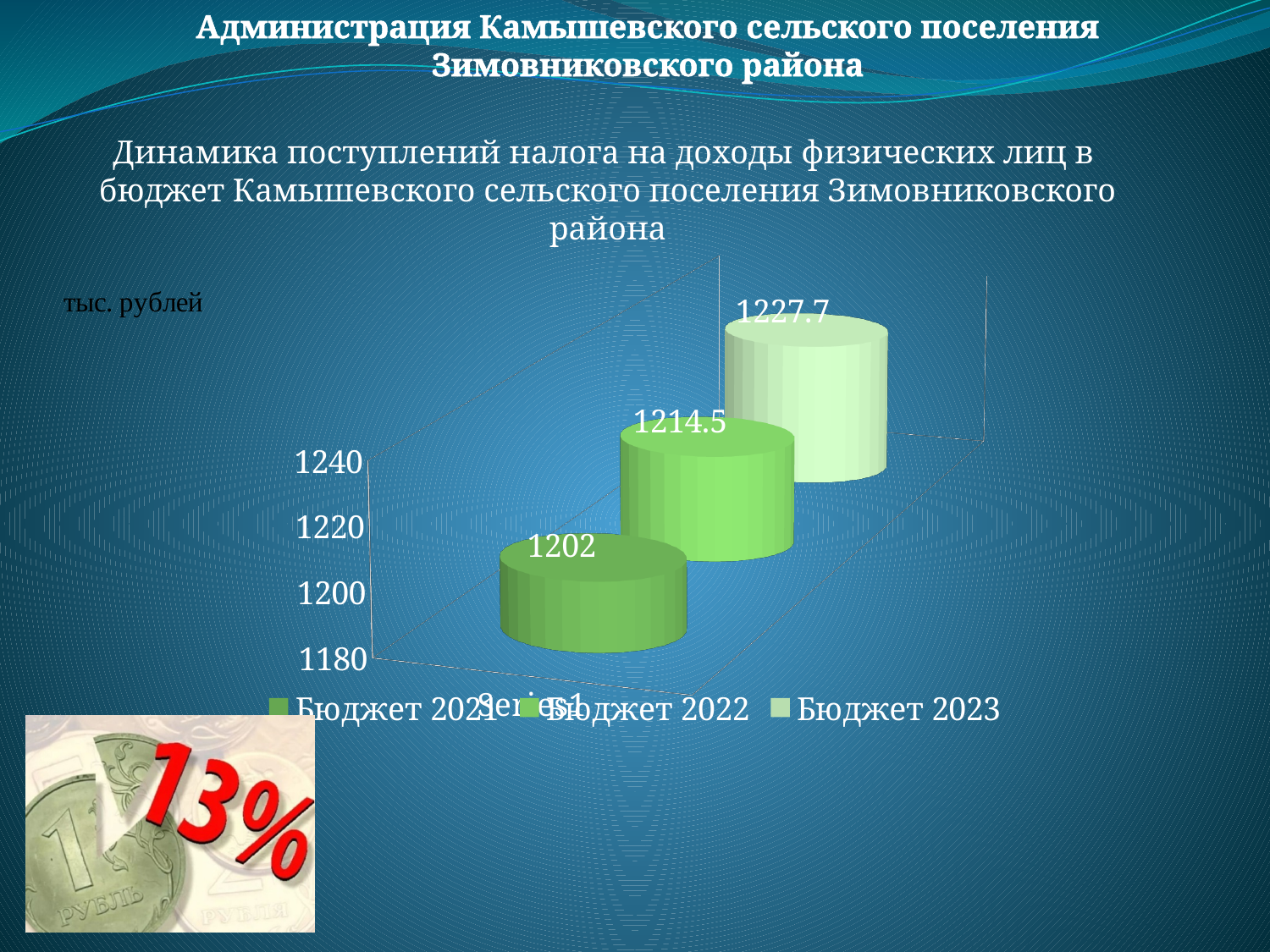
What is the value for Бюджет 2023? 1227.7 What is the value for Бюджет 2021? 1202 Is the value for Бюджет 2021 greater or less than 1220? less Do the values rise or fall from Бюджет 2021 to Бюджет 2023? rise What is the difference between the values for Бюджет 2023 and Бюджет 2021? 25.7 What is the value for Бюджет 2022? 1214.5 Which is larger, the value for Бюджет 2022 or Бюджет 2023? Бюджет 2023 What is the difference between the values for Бюджет 2022 and Бюджет 2021? 12.5 How many series does the legend list? 3 Which budget year has the highest value? Бюджет 2023 Which budget year has the lowest value? Бюджет 2021 What kind of chart is shown on the slide? bar chart